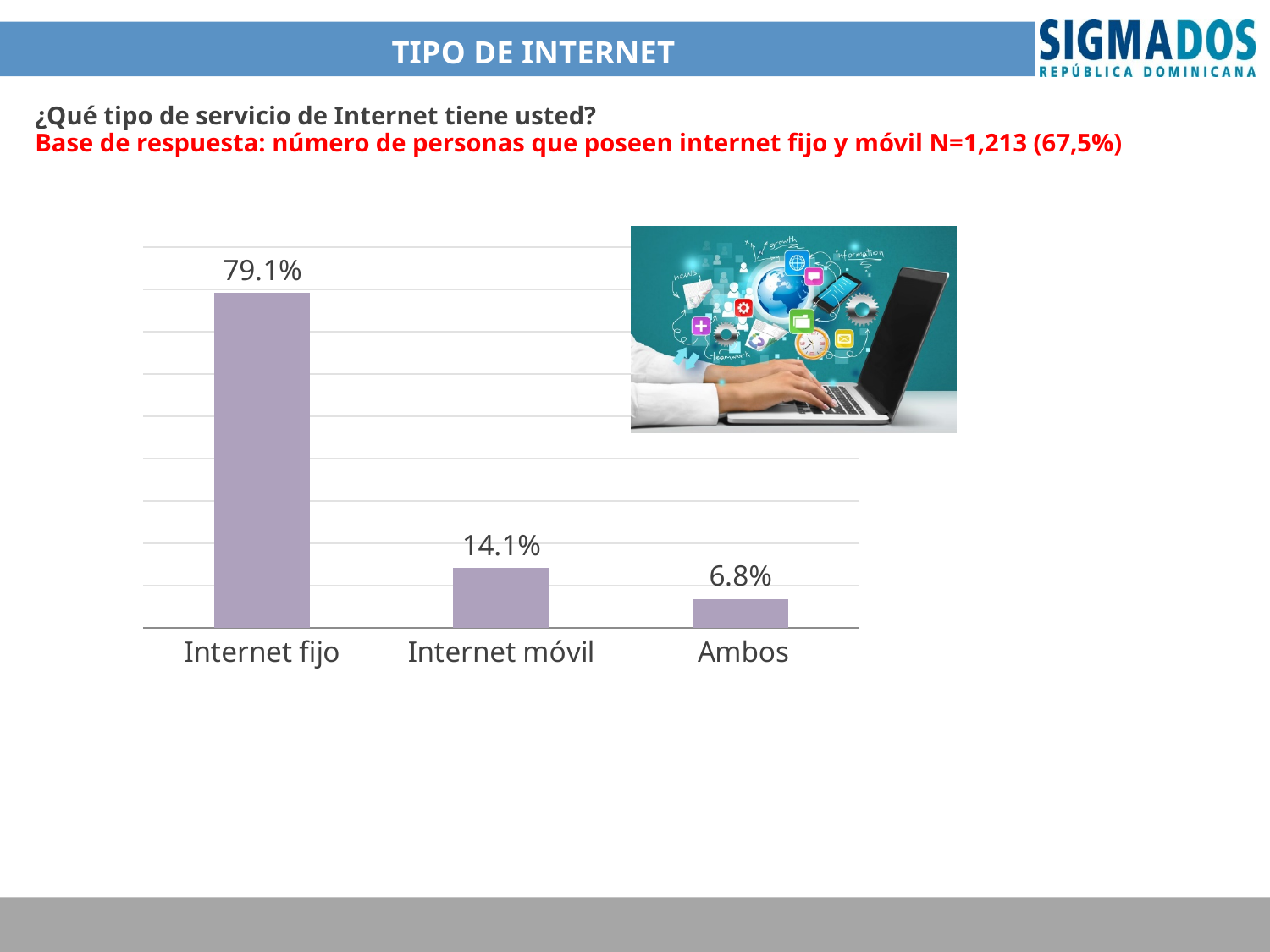
What is the value for Internet fijo? 79.1% Which is larger, the value for Internet móvil or the value for Ambos? Internet móvil What kind of chart is shown on the slide? Bar chart What is the difference between the values for Internet fijo and Internet móvil? 65.0% What is the title shown in the header bar of the slide? TIPO DE INTERNET Do the values rise or fall from left to right across the categories? Fall How many categories are shown in the chart? 3 What is the difference between the values for Internet móvil and Ambos? 7.3% What is the value for Internet móvil? 14.1% What is the value for Ambos? 6.8% Which category has the highest value? Internet fijo Which category has the lowest value? Ambos